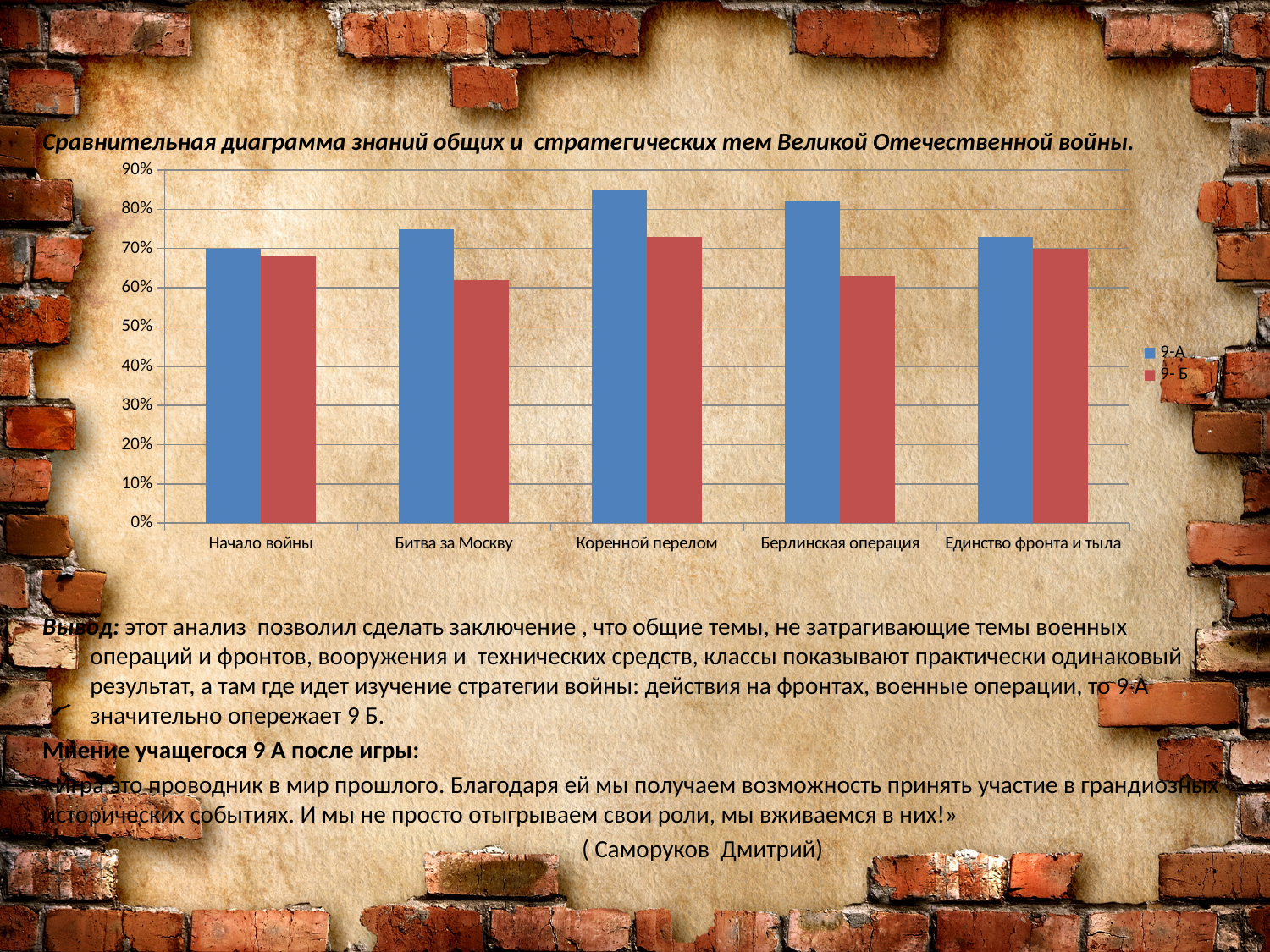
Is the value for 9-А in the category Коренной перелом greater or less than 80%? greater Is the value for 9-Б in the category Битва за Москву greater or less than 70%? less Is the value for 9-Б in the category Берлинская операция greater or less than 70%? less For the category Битва за Москву, which series has the larger value, 9-А or 9-Б? 9-А Which category has the highest value for the 9-А series? Коренной перелом How many series does the chart legend list? 2 How many categories are shown on the x axis of the chart? 5 What is the maximum value shown on the chart's vertical axis? 90% Which two series are listed in the chart legend? 9-А and 9-Б What kind of chart is shown on the slide? bar chart For the category Берлинская операция, which series has the larger value, 9-А or 9-Б? 9-А